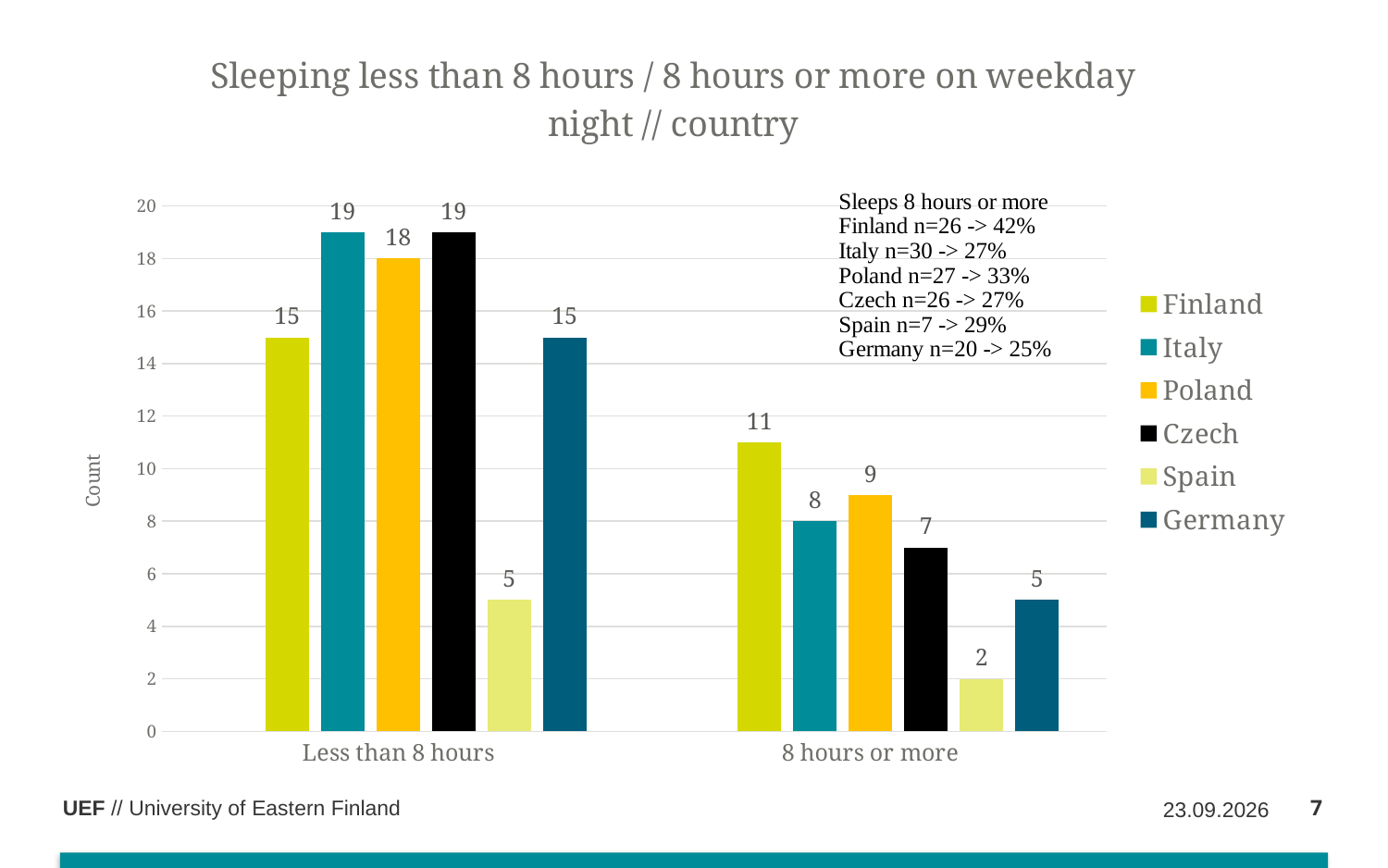
Which country has the lowest count in the 'Less than 8 hours' category? Spain How many categories are shown on the x axis? 2 What is the count for Poland in the 'Less than 8 hours' category? 18 Which is larger: Germany's count for 'Less than 8 hours' or Czech's count for '8 hours or more'? Germany's count for 'Less than 8 hours' What kind of chart is shown on the slide? Bar chart How many series does the legend list? 6 What is the label of the y axis? Count Which country has the highest count in the '8 hours or more' category? Finland What is the count for Finland in the 'Less than 8 hours' category? 15 What is the difference between Finland's and Italy's counts in the '8 hours or more' category? 3 What is the count for Spain in the '8 hours or more' category? 2 What is the difference between Italy's count for 'Less than 8 hours' and its count for '8 hours or more'? 11